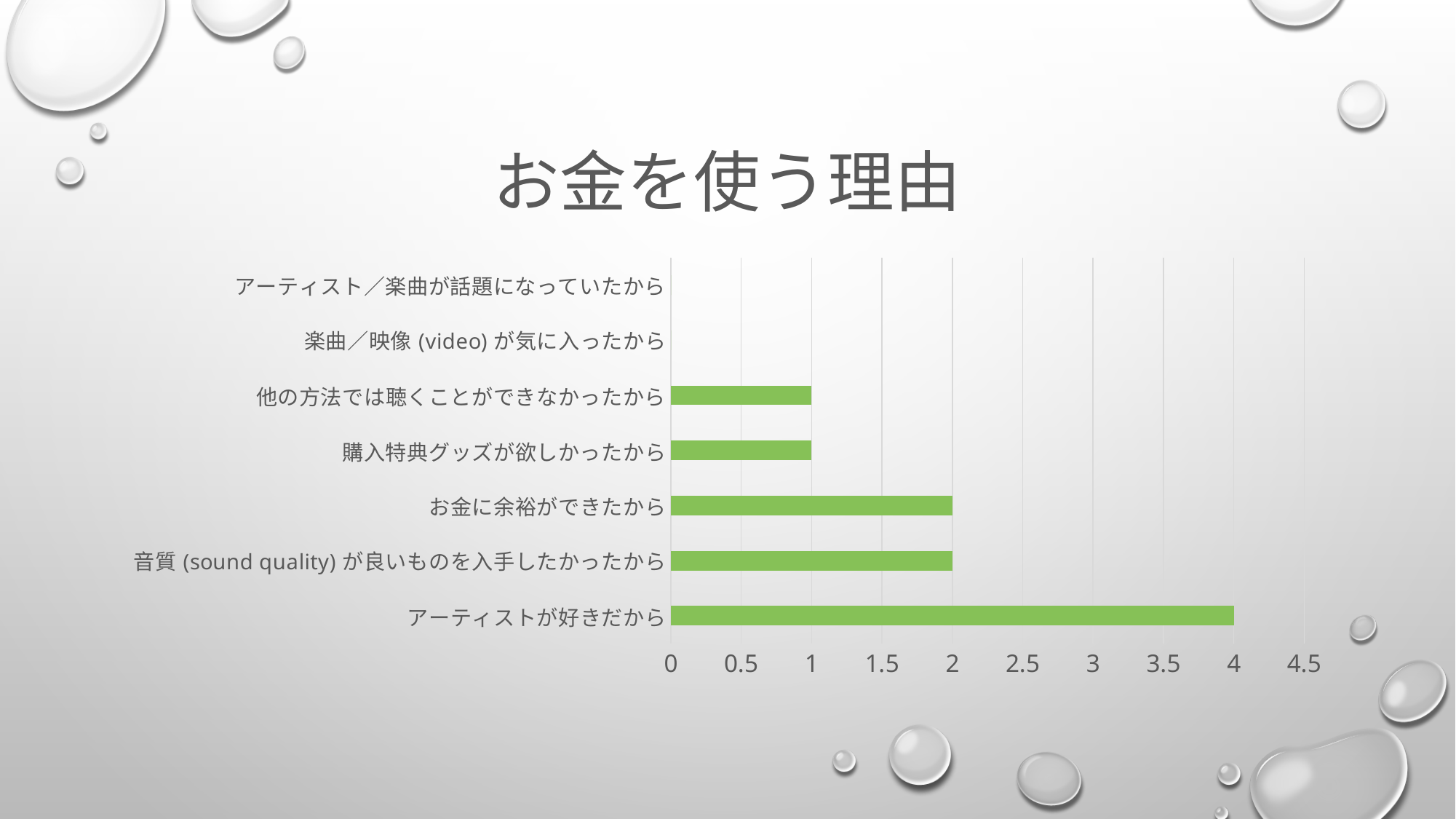
What is the value for 音質 (sound quality) が良いものを入手したかったから? 2 What type of chart is shown on the slide? bar chart What is the title of the chart? お金を使う理由 What is the difference between the values for アーティストが好きだから and お金に余裕ができたから? 2 Is the value for アーティストが好きだから greater or less than 3? greater What is the value for 購入特典グッズが欲しかったから? 1 Which category has the highest value? アーティストが好きだから Which is larger, the value for アーティストが好きだから or the value for 購入特典グッズが欲しかったから? アーティストが好きだから What is the difference between the values for 音質 (sound quality) が良いものを入手したかったから and 他の方法では聴くことができなかったから? 1 What is the value for お金に余裕ができたから? 2 What is the value for アーティストが好きだから? 4 How many categories are listed on the chart? 7